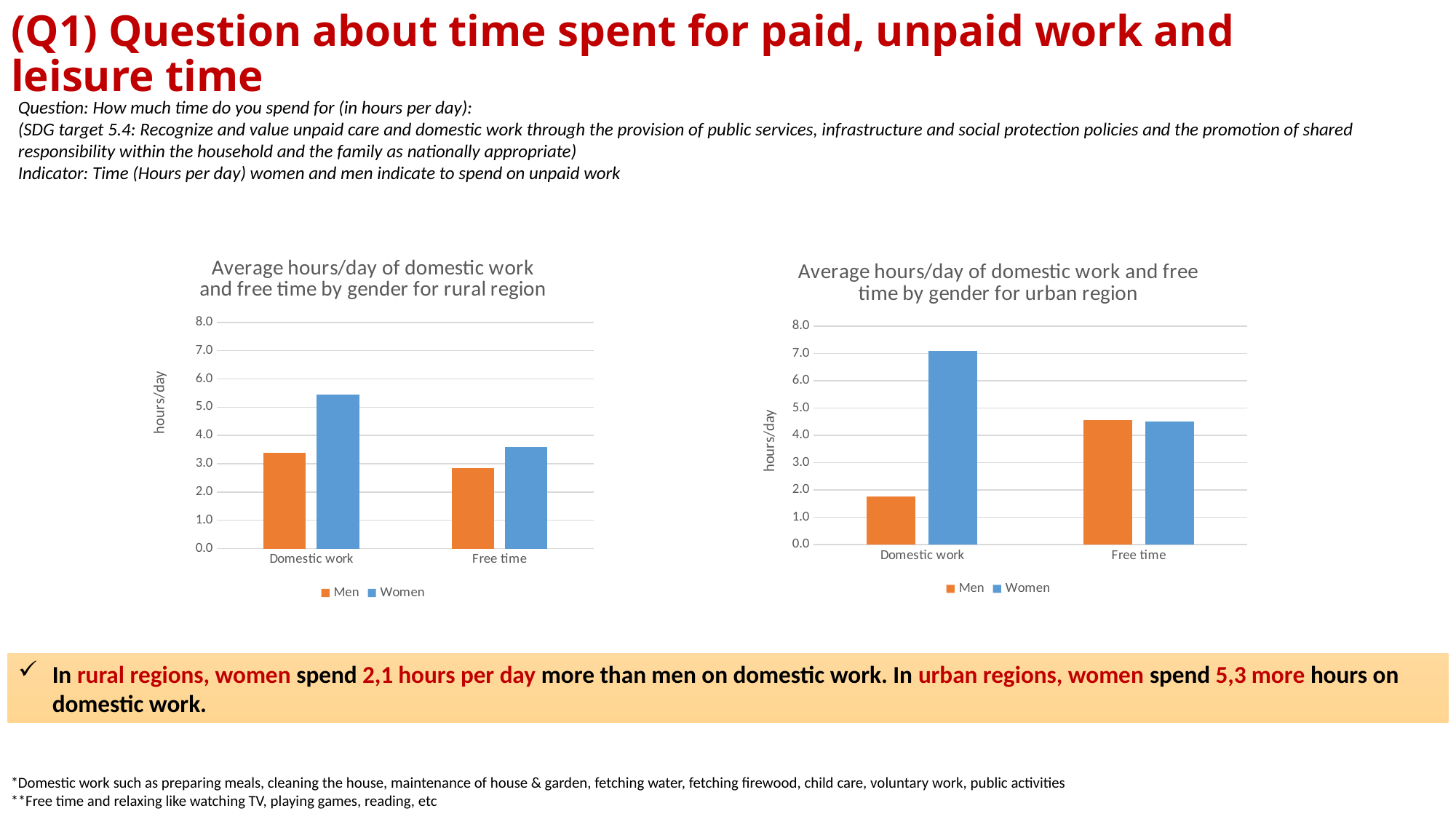
In the urban region chart, which bar is the tallest? Women, Domestic work In the rural region chart, is the value for Men on Free time greater or less than 3.0? less In the rural region chart, is the value for Men on Domestic work greater or less than 4.0? less What kind of chart is the 'Average hours/day of domestic work and free time by gender for rural region' chart? bar chart What is the y-axis label on the rural region chart? hours/day How many series does the legend list in the 'Average hours/day of domestic work and free time by gender for urban region' chart? 2 In the urban region chart, which series has the higher value for Domestic work, Men or Women? Women In the rural region chart, which series has the higher value for Free time, Men or Women? Women In the urban region chart, is the value for Men on Domestic work greater or less than 2.0? less How many categories are shown on the x axis of the rural region chart? 2